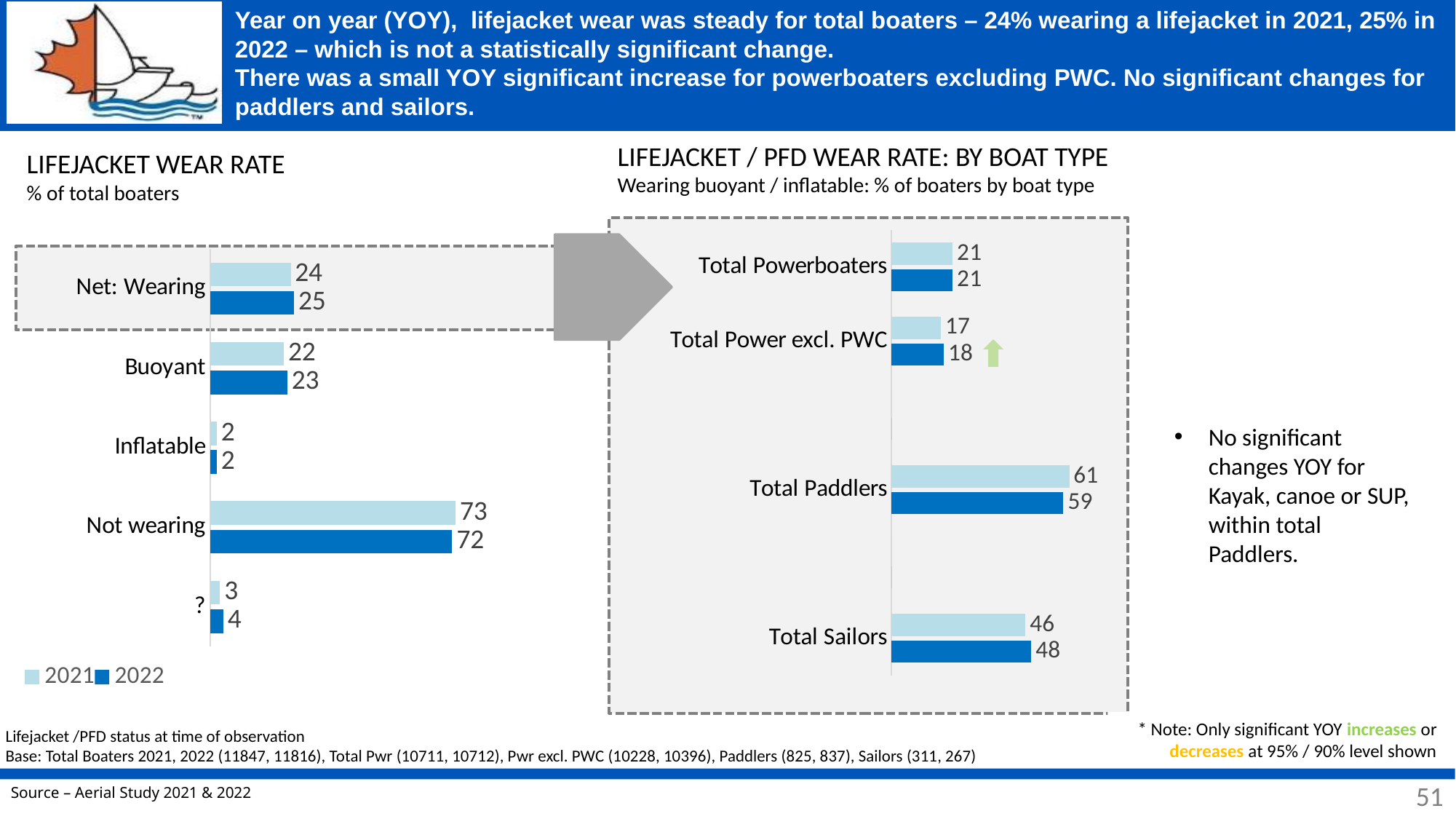
In the LIFEJACKET WEAR RATE chart, what is the 2021 value for Not wearing? 73 How many boat type categories are shown in the LIFEJACKET / PFD WEAR RATE: BY BOAT TYPE chart? 4 In the LIFEJACKET / PFD WEAR RATE: BY BOAT TYPE chart, what is the 2022 value for Total Sailors? 48 In the LIFEJACKET / PFD WEAR RATE: BY BOAT TYPE chart, what is the difference between the 2021 and 2022 values for Total Paddlers? 2 In the LIFEJACKET WEAR RATE chart, which category has the highest 2022 value? Not wearing In the LIFEJACKET / PFD WEAR RATE: BY BOAT TYPE chart, which is larger: the 2022 value for Total Paddlers or the 2022 value for Total Sailors? Total Paddlers In the LIFEJACKET / PFD WEAR RATE: BY BOAT TYPE chart, which boat type has the lowest 2021 value? Total Power excl. PWC In the LIFEJACKET WEAR RATE chart, what is the 2022 value for Net: Wearing? 25 What kind of chart is the LIFEJACKET WEAR RATE chart? Bar chart In the LIFEJACKET WEAR RATE chart, how many series does the legend list? 2 In the LIFEJACKET WEAR RATE chart, what is the difference between the 2021 and 2022 values for Buoyant? 1 In the LIFEJACKET / PFD WEAR RATE: BY BOAT TYPE chart, what is the 2021 value for Total Paddlers? 61